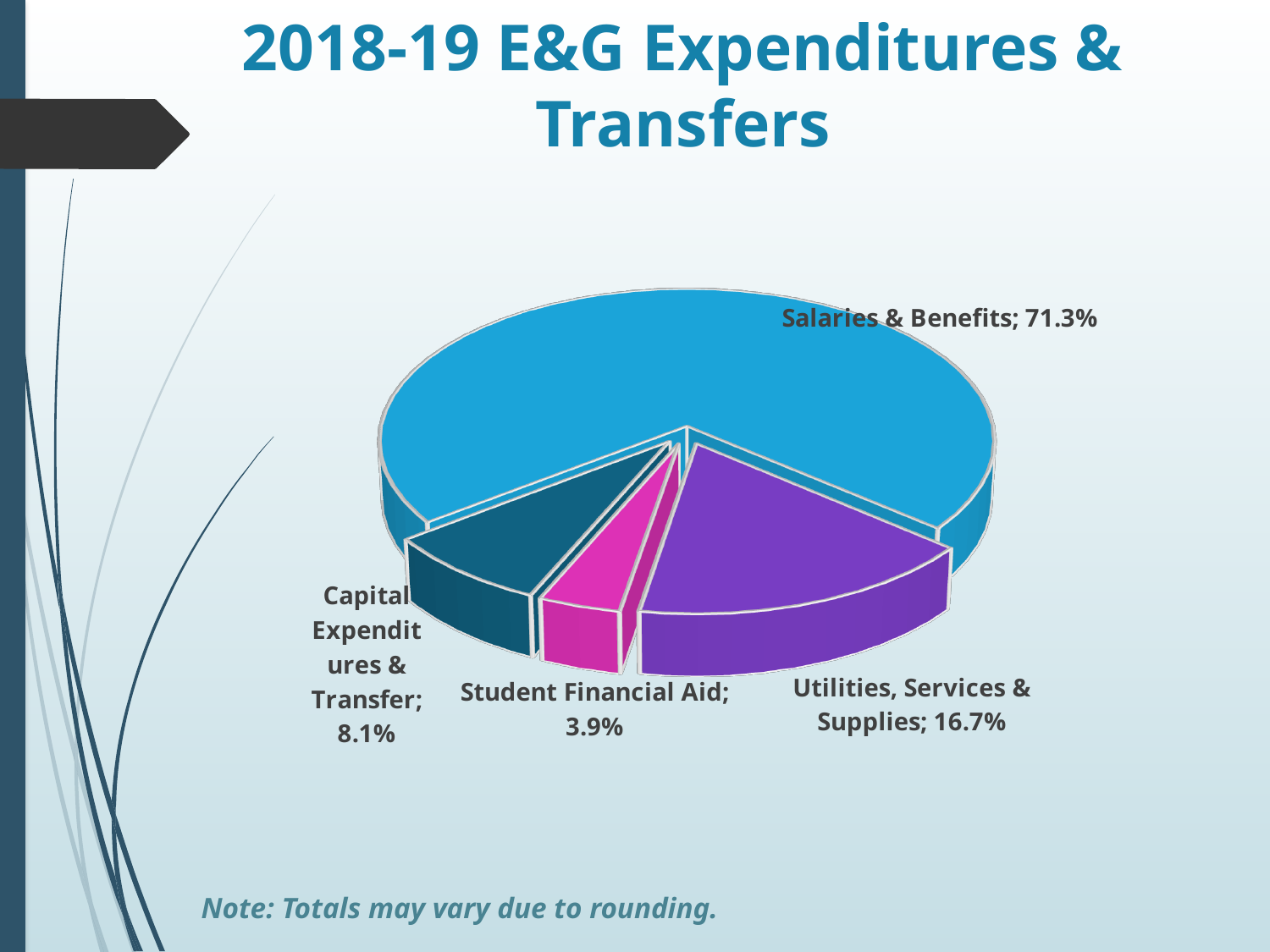
Which is larger, the share for Utilities, Services & Supplies or the share for Capital Expenditures & Transfer? Utilities, Services & Supplies What kind of chart is shown on the slide? Pie chart What percentage does the Utilities, Services & Supplies slice represent? 16.7% Which category has the largest share of the pie? Salaries & Benefits What percentage is labelled for Capital Expenditures & Transfer? 8.1% How many slices does the pie chart have? 4 What is the value shown for Student Financial Aid? 3.9% What is the title of the chart on the slide? 2018-19 E&G Expenditures & Transfers What is the difference in percentage points between Capital Expenditures & Transfer and Student Financial Aid? 4.2 What is the difference in percentage points between Salaries & Benefits and Utilities, Services & Supplies? 54.6 Which category has the smallest share of the pie? Student Financial Aid What share of 2018-19 E&G Expenditures & Transfers is Salaries & Benefits? 71.3%